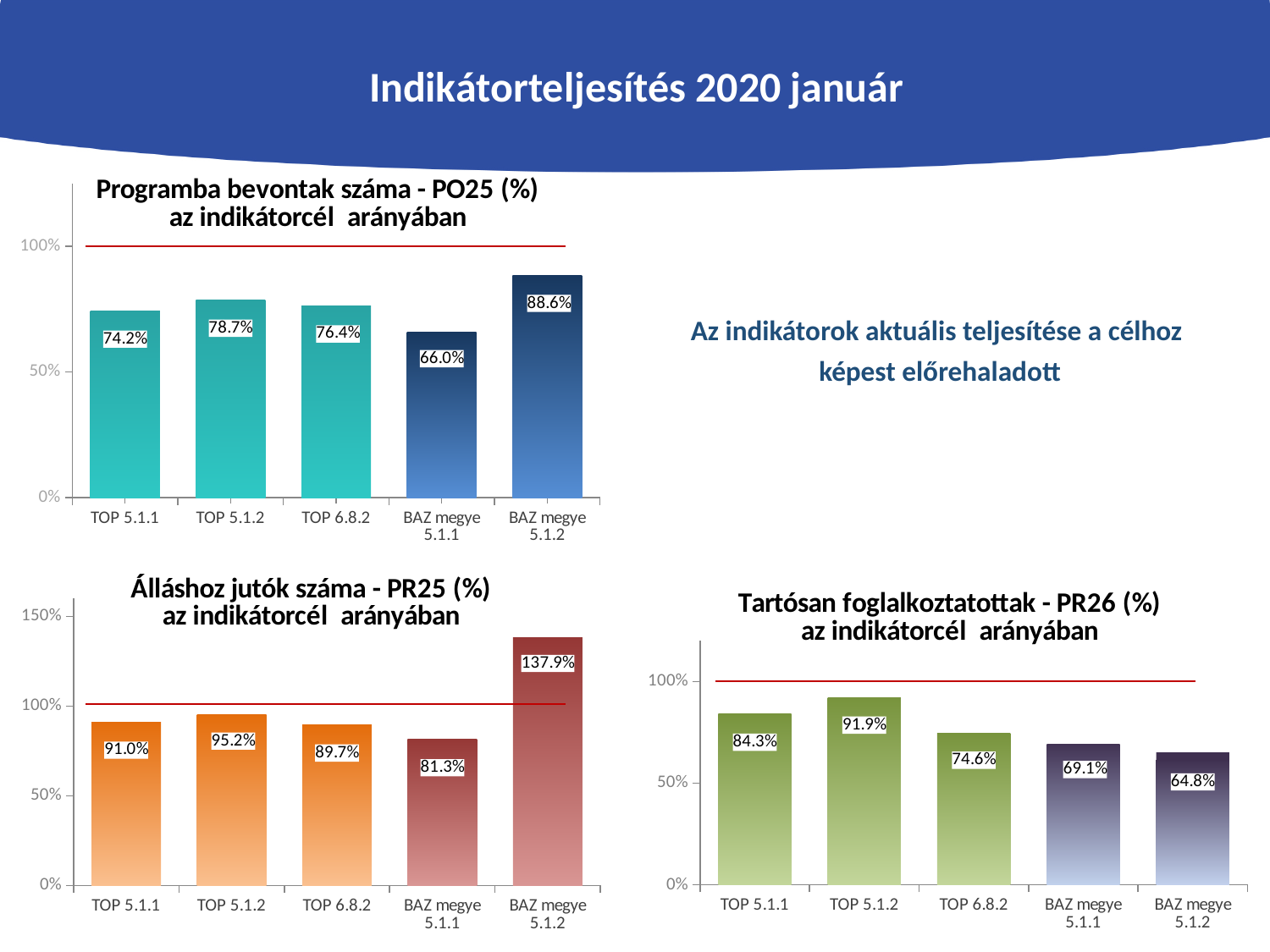
In the 'Álláshoz jutók száma - PR25 (%)' chart, what is the value for BAZ megye 5.1.2? 137.9% In the 'Tartósan foglalkoztatottak - PR26 (%)' chart, what is the difference between TOP 5.1.1 and TOP 6.8.2? 9.7% In the 'Álláshoz jutók száma - PR25 (%)' chart, which is larger, TOP 5.1.2 or TOP 6.8.2? TOP 5.1.2 In the 'Programba bevontak száma - PO25 (%)' chart, what is the difference between TOP 5.1.2 and TOP 5.1.1? 4.5% In the 'Programba bevontak száma - PO25 (%)' chart, which category has the lowest value? BAZ megye 5.1.1 In the 'Tartósan foglalkoztatottak - PR26 (%)' chart, what is the value for TOP 5.1.2? 91.9% In the 'Tartósan foglalkoztatottak - PR26 (%)' chart, which category has the lowest value? BAZ megye 5.1.2 In the 'Álláshoz jutók száma - PR25 (%)' chart, is the value for BAZ megye 5.1.1 greater or less than 100%? less What kind of chart is the 'Programba bevontak száma - PO25 (%)' chart? bar chart In the 'Álláshoz jutók száma - PR25 (%)' chart, which category has the highest value? BAZ megye 5.1.2 In the 'Programba bevontak száma - PO25 (%)' chart, what is the value for BAZ megye 5.1.2? 88.6% How many categories are shown in the 'Tartósan foglalkoztatottak - PR26 (%)' chart? 5